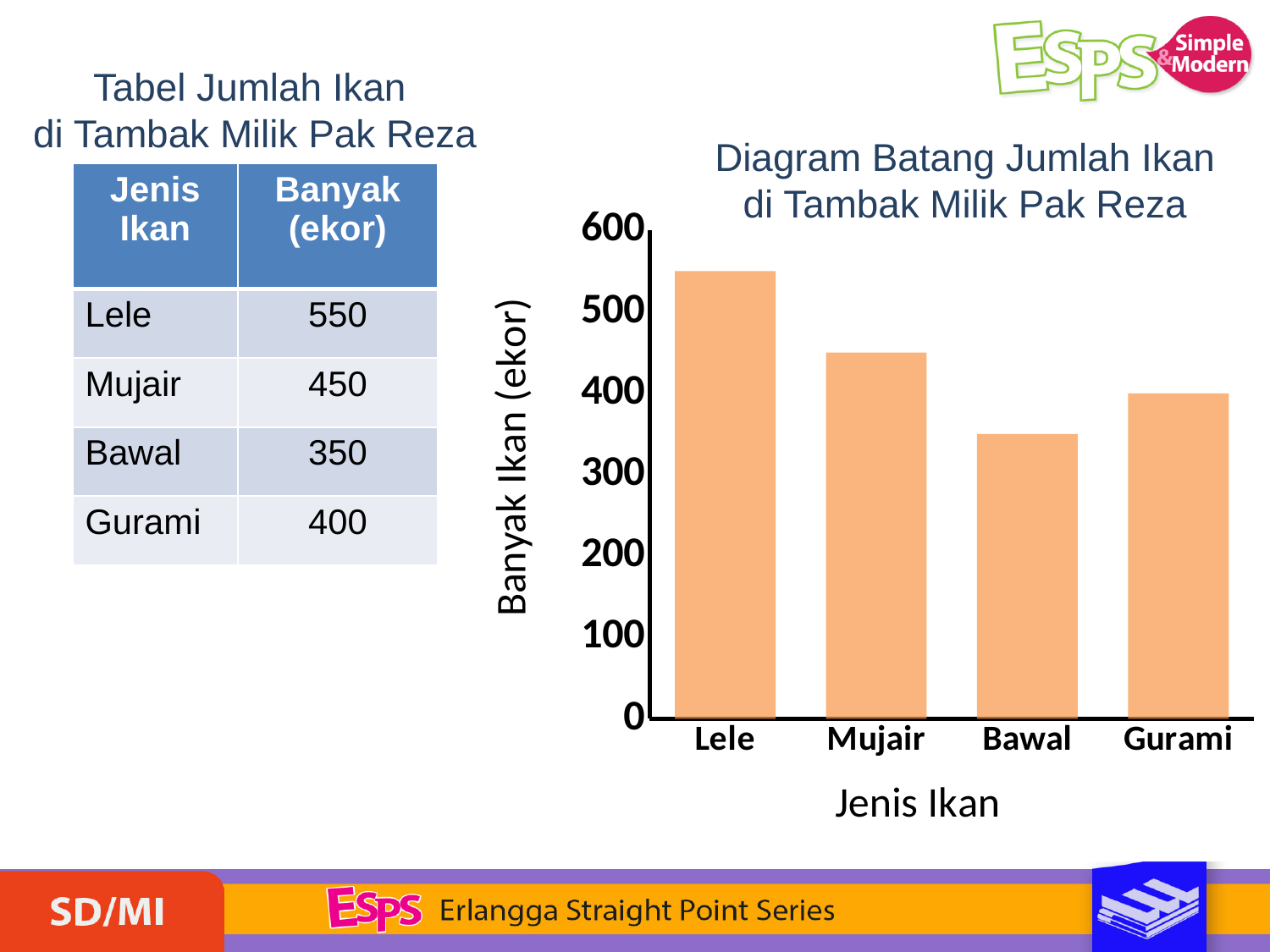
What is the difference between the number of Lele and the number of Bawal? 200 Which type of fish has the highest number in the bar chart? Lele Which is larger, the number of Mujair or the number of Gurami? Mujair What is the label of the vertical axis of the bar chart? Banyak Ikan (ekor) How many Gurami fish are there according to the slide? 400 Is the value for Bawal greater or less than 400? less How many types of fish (categories) are shown in the bar chart? 4 Which type of fish has the lowest number in the bar chart? Bawal What is the title of the bar chart? Diagram Batang Jumlah Ikan di Tambak Milik Pak Reza How many Lele fish are there according to the slide? 550 How many Mujair fish are there according to the slide? 450 What kind of chart is shown on the slide? bar chart